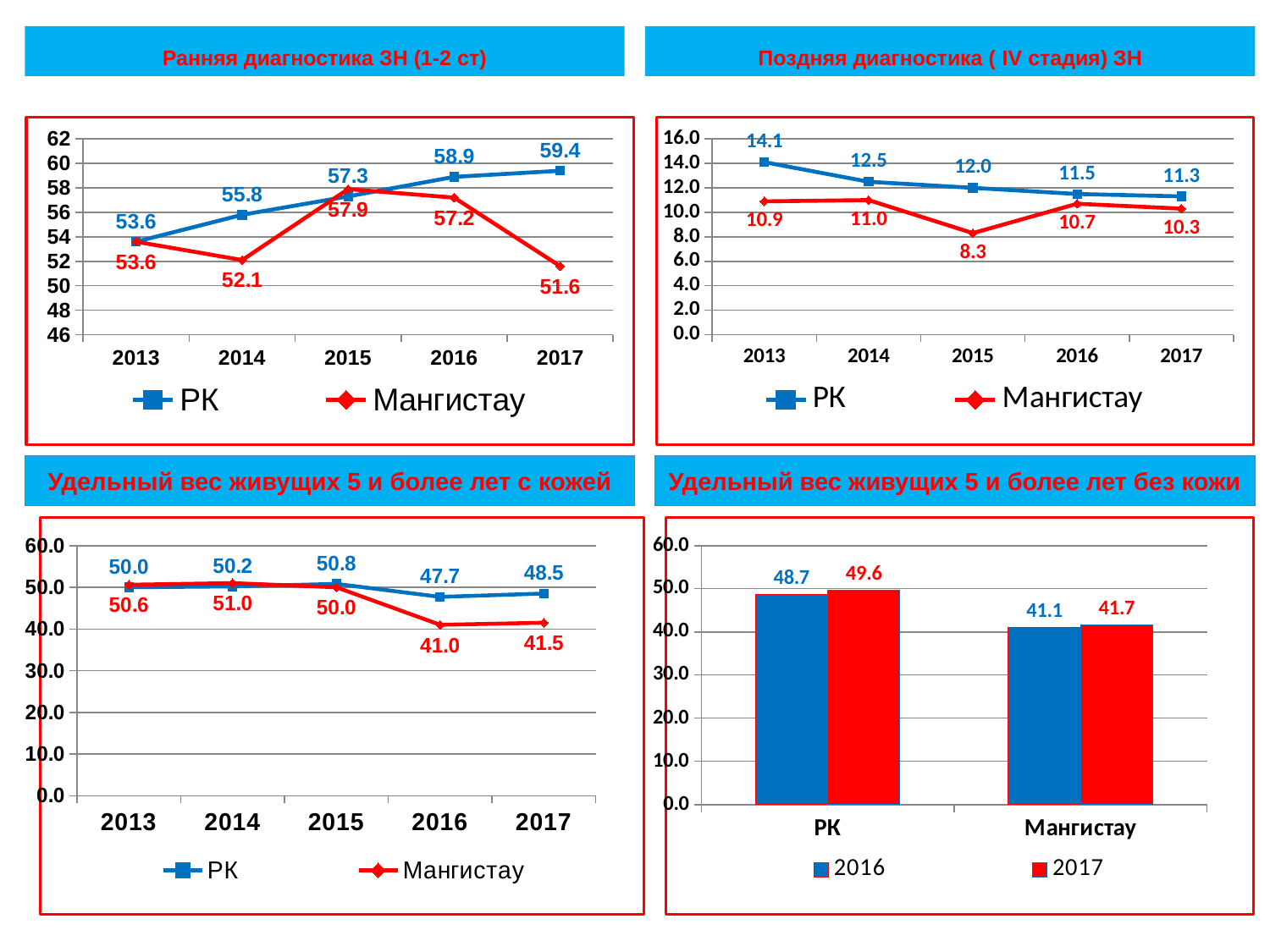
In the 'Удельный вес живущих 5 и более лет без кожи' chart, how many series does the legend list? 2 In the 'Поздняя диагностика ( IV стадия) ЗН' chart, which is larger in 2016, РК or Мангистау? РК In the 'Поздняя диагностика ( IV стадия) ЗН' chart, does the РК series rise or fall from 2013 to 2017? fall In the 'Удельный вес живущих 5 и более лет с кожей' chart, in which year is the РК value highest? 2015 What kind of chart is 'Удельный вес живущих 5 и более лет без кожи'? bar chart In the 'Удельный вес живущих 5 и более лет с кожей' chart, what is the value for Мангистау in 2016? 41.0 In the 'Ранняя диагностика ЗН (1-2 ст)' chart, what is the value for РК in 2017? 59.4 In the 'Удельный вес живущих 5 и более лет без кожи' chart, what is the value for Мангистау in 2017? 41.7 In the 'Ранняя диагностика ЗН (1-2 ст)' chart, in which year is the Мангистау value lowest? 2017 In the 'Удельный вес живущих 5 и более лет с кожей' chart, how many years are shown on the x axis? 5 In the 'Поздняя диагностика ( IV стадия) ЗН' chart, what is the value for Мангистау in 2015? 8.3 In the 'Ранняя диагностика ЗН (1-2 ст)' chart, what is the difference between РК and Мангистау in 2017? 7.8